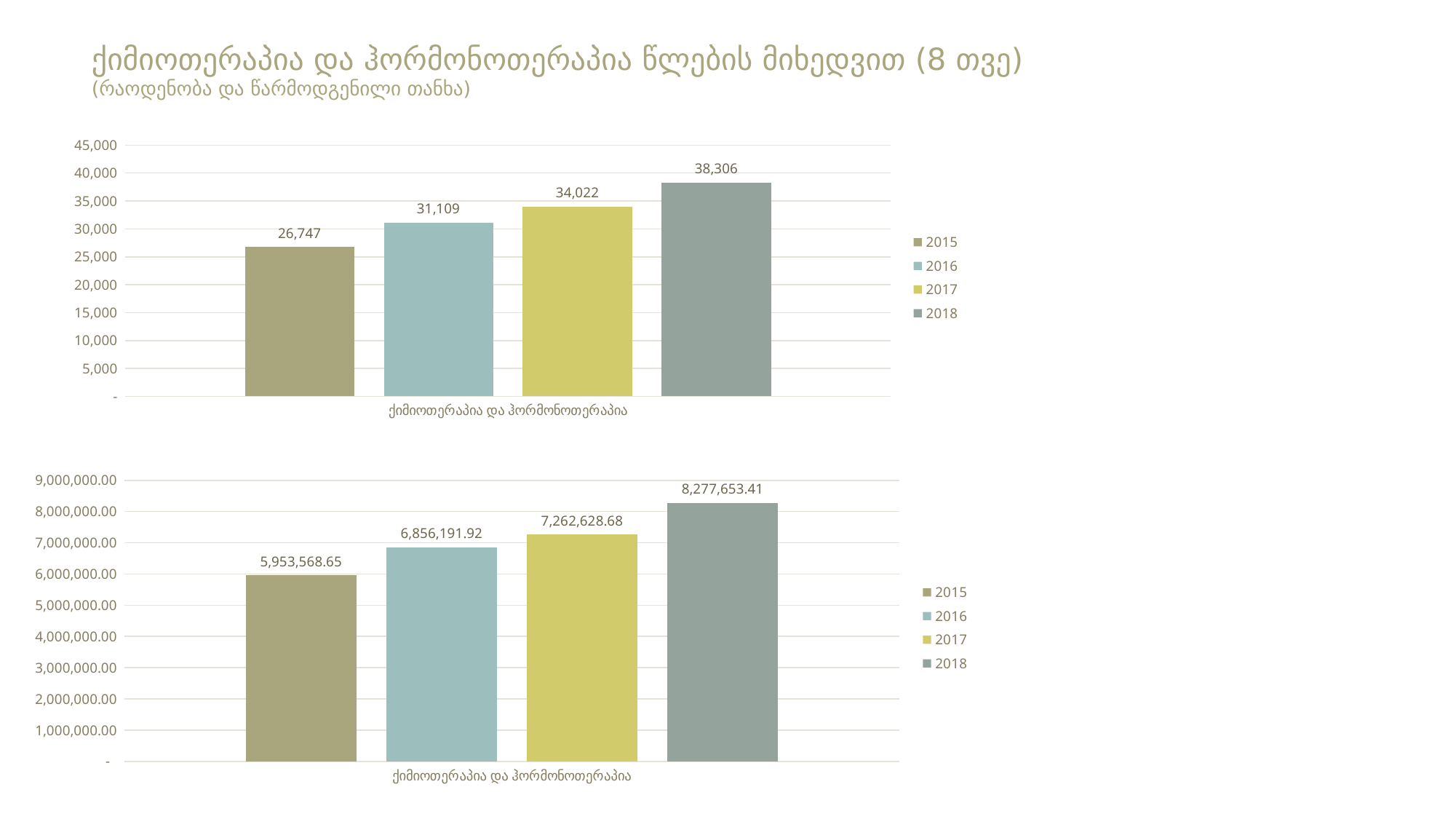
In the bottom chart, which is larger, the value for 2017 or the value for 2016? 2017 In the bottom chart, what is the value for 2016? 6,856,191.92 In the bottom chart, what is the difference between the 2016 and 2015 values? 902,623.27 In the top chart, which year has the highest value? 2018 In the bottom chart, which year has the lowest value? 2015 In the top chart, what is the value for 2015? 26,747 In the top chart, is the value for 2016 greater or less than 30,000? greater How many series does the legend of the bottom chart list? 4 In the top chart, what is the difference between the 2018 and 2015 values? 11,559 Do the values in the top chart rise or fall from 2015 to 2018? rise In the bottom chart, what is the value for 2018? 8,277,653.41 In the top chart, what is the value for 2017? 34,022